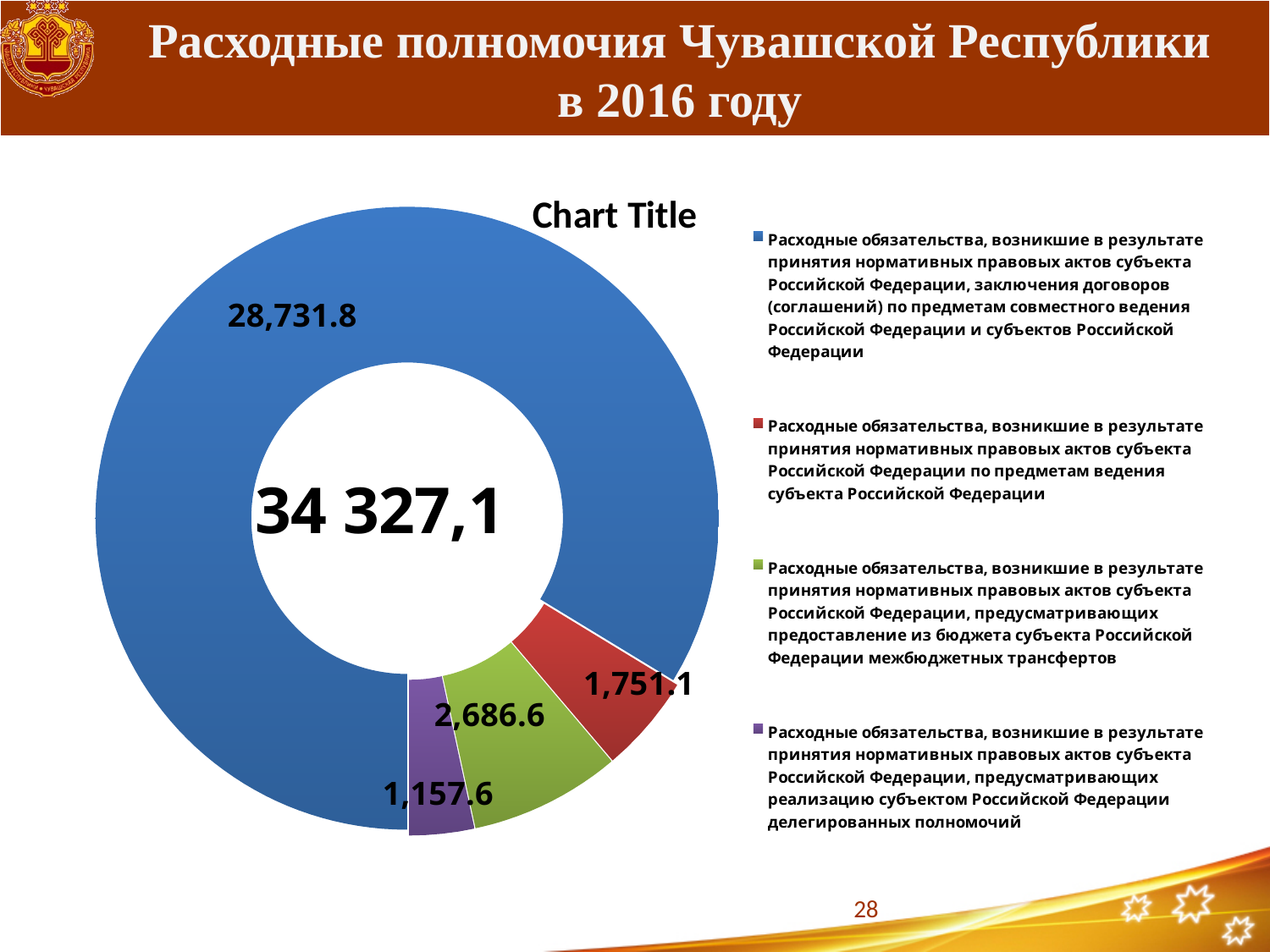
What is the value of the purple slice (реализация делегированных полномочий)? 1,157.6 What is the value of the red slice (обязательства по предметам ведения субъекта Российской Федерации)? 1,751.1 What is the difference between the green slice (2,686.6) and the red slice (1,751.1)? 935.5 What is the title shown above the chart? Chart Title How many slices does the doughnut chart have? 4 Which slice has the largest value? The blue slice (обязательства по предметам совместного ведения), 28,731.8 What kind of chart is shown on the slide? Doughnut (pie) chart Which slice has the smallest value? The purple slice (реализация делегированных полномочий), 1,157.6 What total value is printed in the centre of the doughnut chart? 34 327,1 How many entries does the legend list? 4 What is the value of the green slice (предоставление межбюджетных трансфертов)? 2,686.6 What is the value of the blue slice (обязательства по предметам совместного ведения Российской Федерации и субъектов Российской Федерации)? 28,731.8